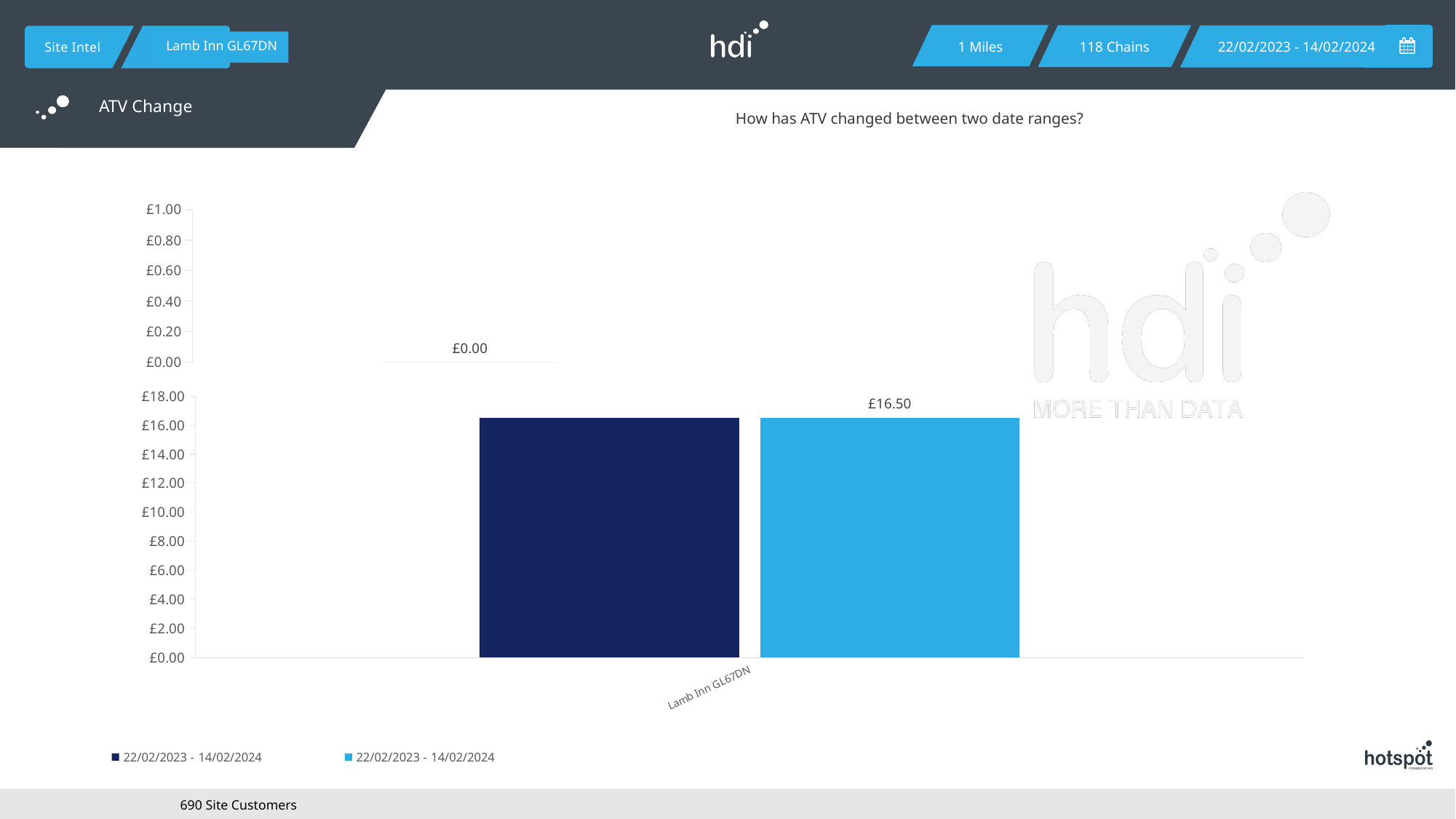
What value is labelled in the upper (ATV change) chart? £0.00 How many categories are shown on the x axis of the lower chart? 1 In the lower chart, is the value of the dark navy bar greater or less than £14.00? greater In the lower chart, is the value of the dark navy bar for Lamb Inn GL67DN greater or less than £10.00? greater What is the highest tick value shown on the y axis of the lower chart? £18.00 What question is posed as the chart's heading on the slide? How has ATV changed between two date ranges? What is the category label on the x axis of the lower chart? Lamb Inn GL67DN How many series does the legend list? 2 In the lower chart, is the value of the light blue bar for Lamb Inn GL67DN greater or less than £18.00? less What kind of chart is shown on the slide? bar chart What is the value labelled on the light blue bar for Lamb Inn GL67DN in the lower chart? £16.50 How many bars are plotted in the lower chart? 2